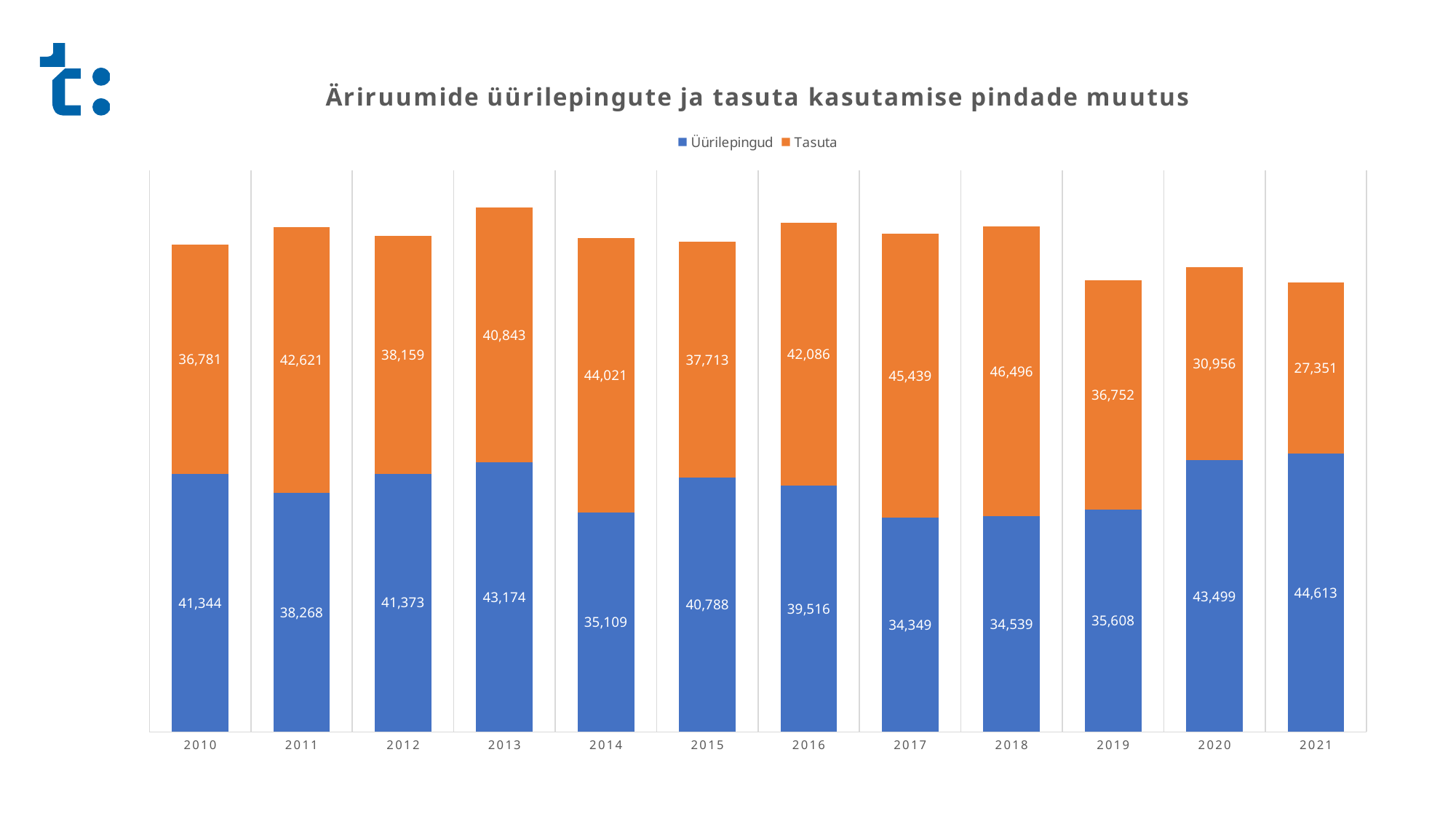
Which year has the lowest Üürilepingud value? 2017 How many years are shown on the x axis? 12 Which year has the highest Tasuta value? 2018 What is the Üürilepingud value for 2019? 35,608 What is the Tasuta value for 2017? 45,439 What is the total of the stacked bar for 2013? 84,017 What is the Üürilepingud value for 2013? 43,174 How many series does the legend list? 2 What is the difference between the Üürilepingud and Tasuta values in 2021? 17,262 What kind of chart is shown on the slide? Stacked bar chart Which year has the lowest Tasuta value? 2021 Which is larger in 2014, the Üürilepingud value or the Tasuta value? Tasuta